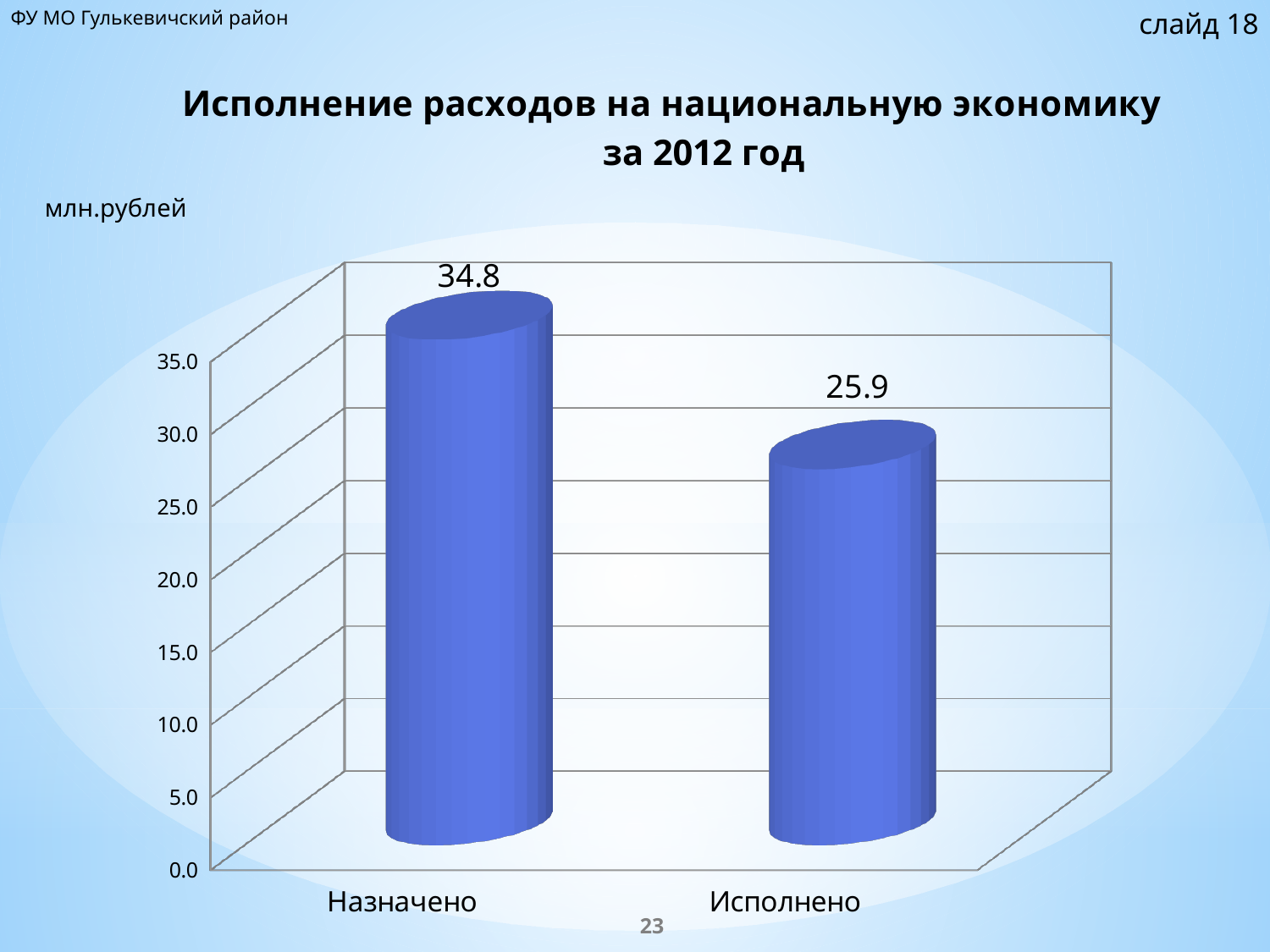
What is the value for Назначено? 34.8 Which category has the lowest value? Исполнено What is the title of the chart? Исполнение расходов на национальную экономику за 2012 год What kind of chart is shown on the slide? bar chart What is the difference between the values for Назначено and Исполнено? 8.9 What is the value for Исполнено? 25.9 How many categories are shown on the chart? 2 Which category has the highest value? Назначено Is the value for Назначено greater or less than 30.0? greater Is the value for Исполнено greater or less than 30.0? less Which is larger, the value for Назначено or the value for Исполнено? Назначено What unit of measurement is indicated for the chart values? млн.рублей